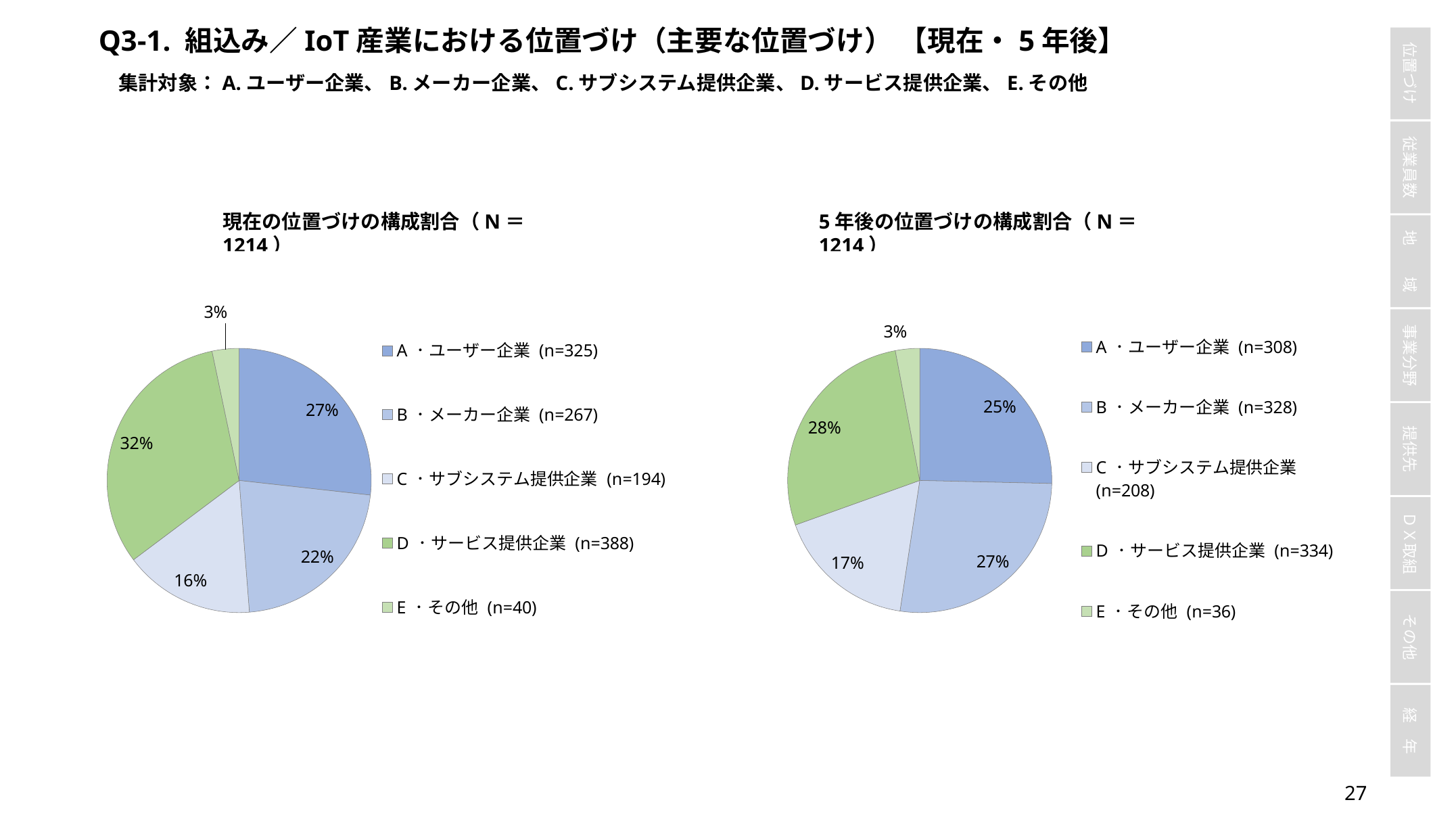
In the left chart (現在の位置づけの構成割合), which category has the largest share? D・サービス提供企業 In the right chart (5年後の位置づけの構成割合), what is the combined share of A・ユーザー企業 and B・メーカー企業? 52% In the left chart (現在の位置づけの構成割合), what is the difference in percentage points between A・ユーザー企業 and C・サブシステム提供企業? 11 percentage points How many slices does the left chart (現在の位置づけの構成割合) have? 5 What type of chart is used on this slide? Pie chart In the right chart (5年後の位置づけの構成割合), which is larger: the share of A・ユーザー企業 or D・サービス提供企業? D・サービス提供企業 In the left chart (現在の位置づけの構成割合), what is the n value shown in the legend for B・メーカー企業? n=267 In the right chart (5年後の位置づけの構成割合), what is the n value shown in the legend for C・サブシステム提供企業? n=208 What is the N value shown in the title of the left chart? 1214 In the right chart (5年後の位置づけの構成割合), what share does B・メーカー企業 hold? 27% In the left chart (現在の位置づけの構成割合), what share does D・サービス提供企業 hold? 32% In the right chart (5年後の位置づけの構成割合), which category has the smallest share? E・その他